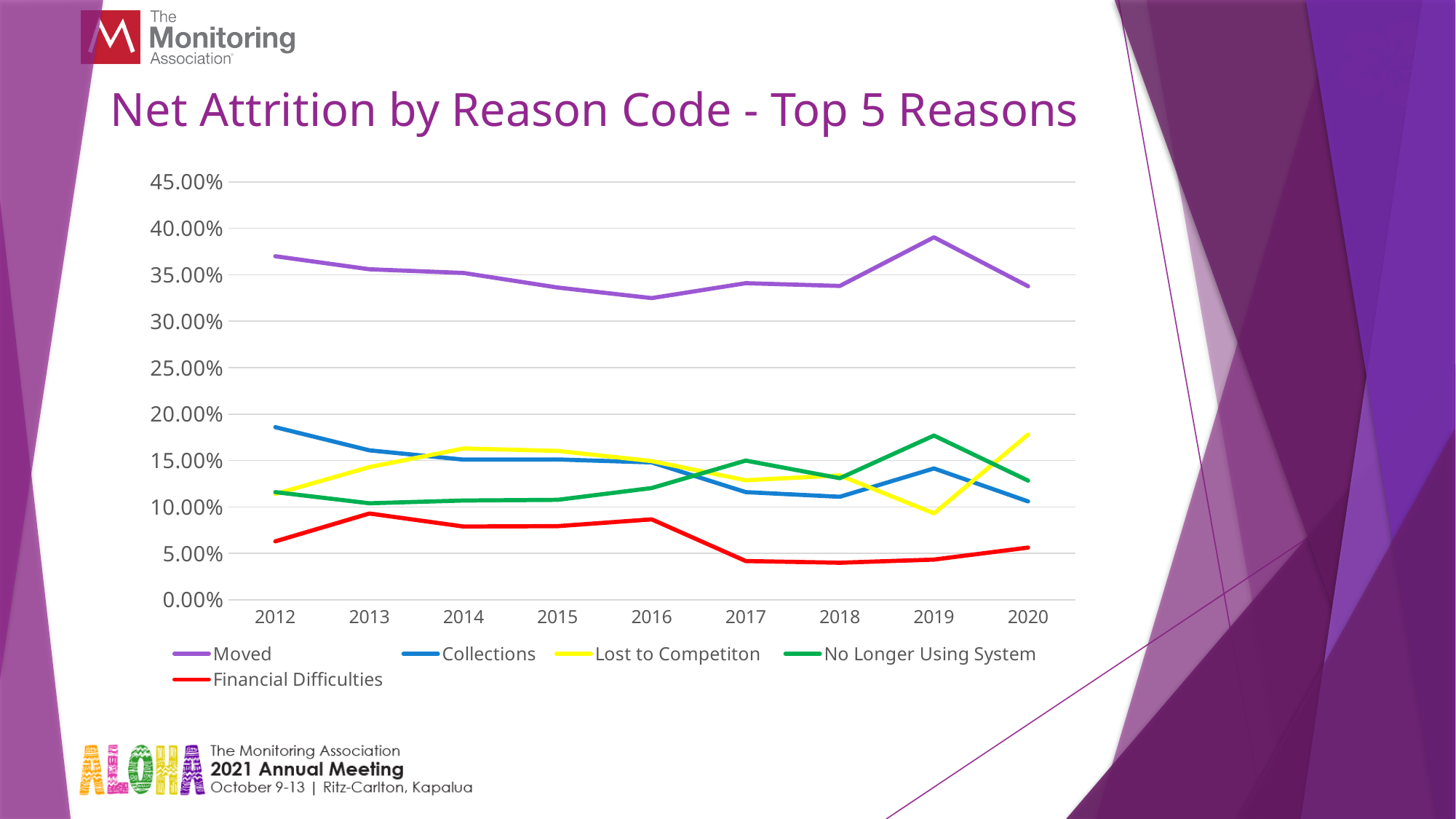
Which reason code has the lowest value in 2020? Financial Difficulties In which year does the Moved series reach its highest value? 2019 Does the Collections series rise or fall overall from 2012 to 2020? fall Is the value for Moved in 2019 greater or less than 35.00%? greater Is the value for Financial Difficulties in 2017 greater or less than 5.00%? less What kind of chart is shown on the slide? line chart In 2012, which is larger: Collections or No Longer Using System? Collections How many series does the legend list? 5 How many years are shown along the x axis? 9 In 2020, which is larger: Lost to Competiton or Collections? Lost to Competiton Which reason code has the highest net attrition across all years shown? Moved What is the title of the chart? Net Attrition by Reason Code - Top 5 Reasons